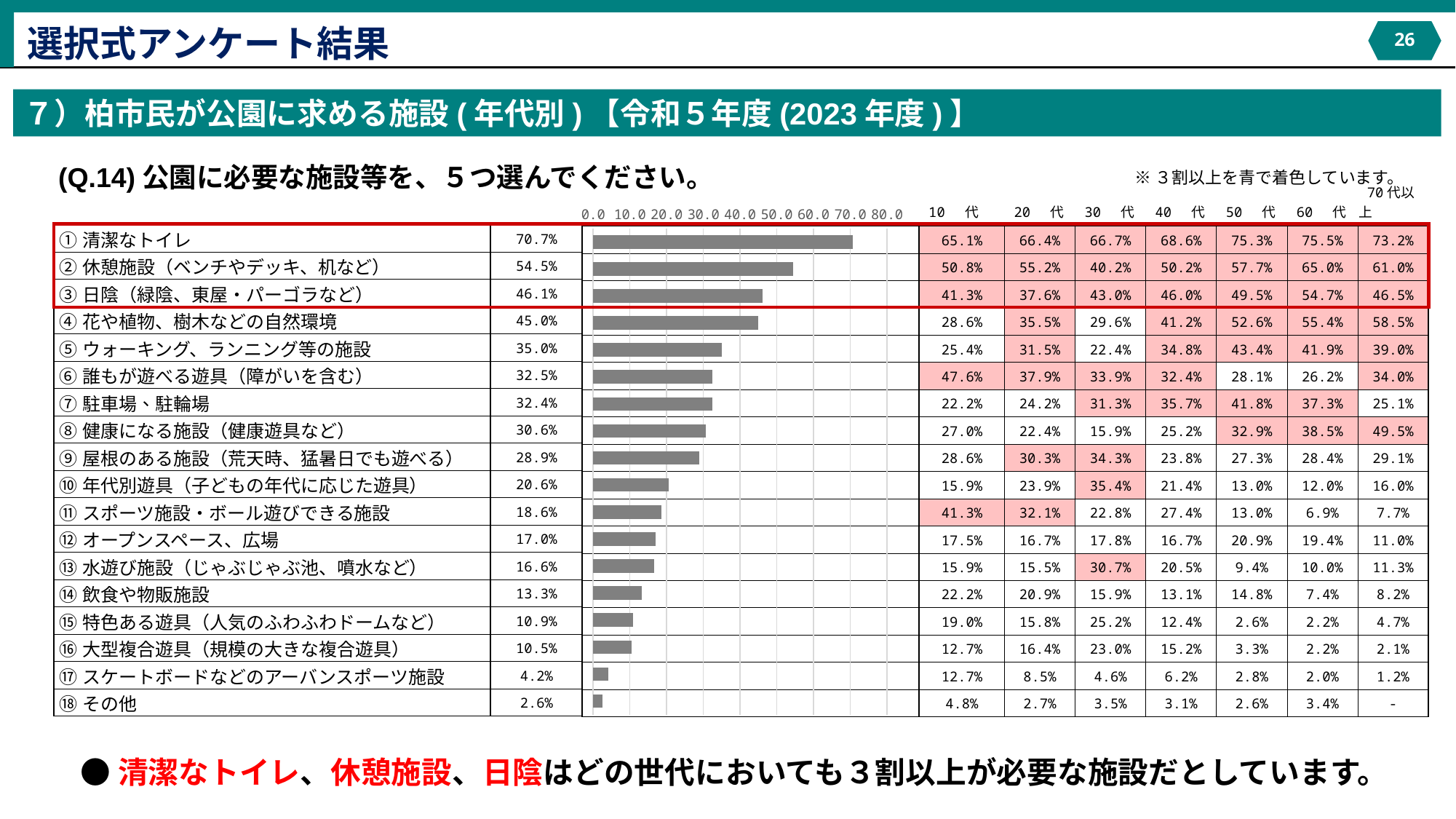
What is the difference between the overall values for ① 清潔なトイレ and ② 休憩施設（ベンチやデッキ、机など）? 16.2% What type of chart is shown on the slide? bar chart What is the overall value for ① 清潔なトイレ? 70.7% What is the overall value for ⑪ スポーツ施設・ボール遊びできる施設? 18.6% What is the maximum value shown on the bar chart's horizontal axis? 80.0 How many categories (facilities) are plotted in the bar chart? 18 Is the overall value for ④ 花や植物、樹木などの自然環境 greater or less than 40.0? greater Which has a larger overall value: ⑤ ウォーキング、ランニング等の施設 or ⑨ 屋根のある施設（荒天時、猛暑日でも遊べる）? ⑤ ウォーキング、ランニング等の施設 What is the overall value for ⑰ スケートボードなどのアーバンスポーツ施設? 4.2% What is the overall value for ③ 日陰（緑陰、東屋・パーゴラなど）? 46.1% Which category has the highest overall value in the bar chart? ① 清潔なトイレ Which category has the lowest overall value in the bar chart? ⑱ その他